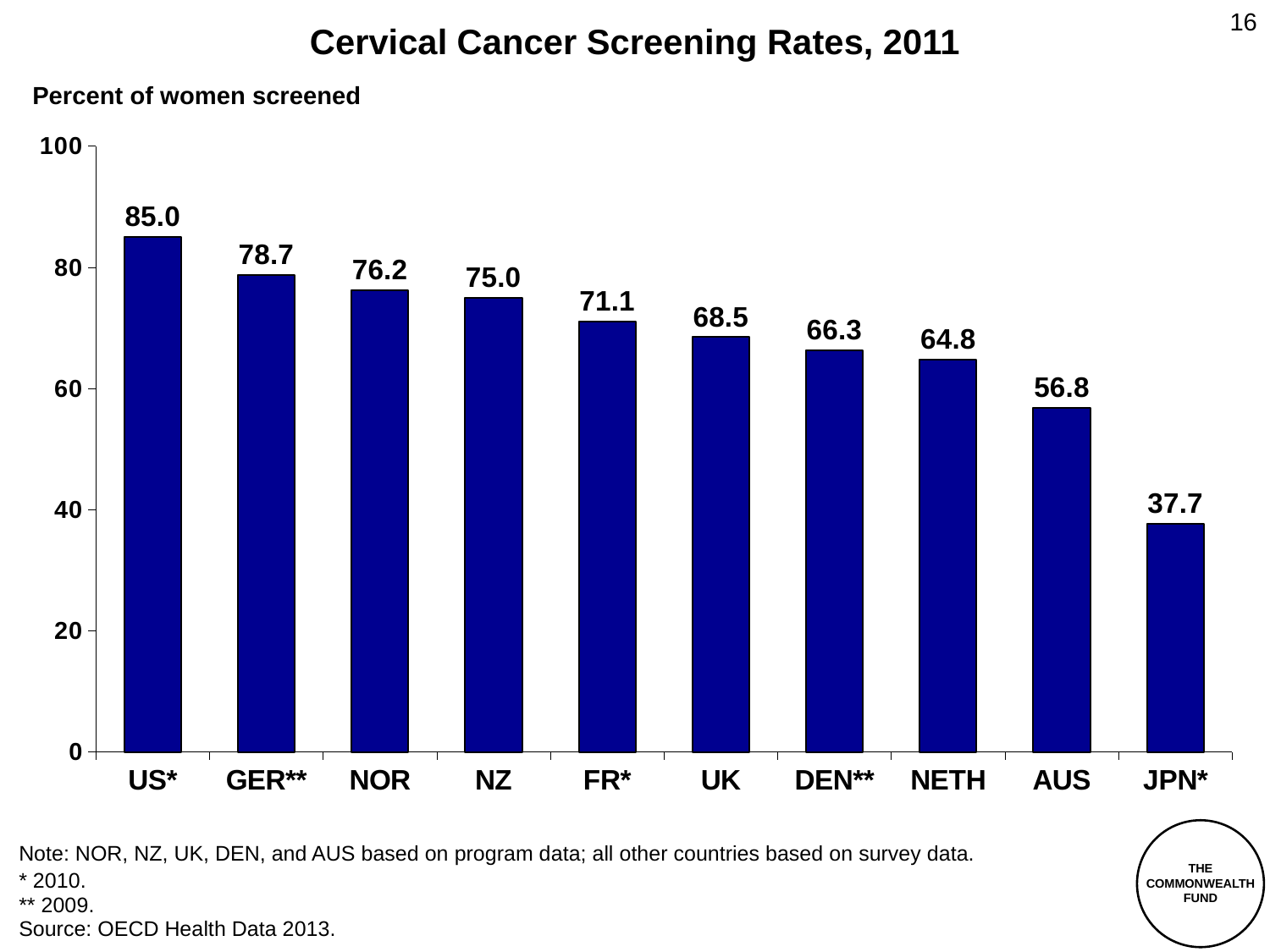
What is the difference between the values for GER** and NETH? 13.9 What is the value shown for DEN**? 66.3 Which country has the lowest screening rate? JPN* How many countries are shown in the chart? 10 Is the value for FR* greater or less than 80? less What kind of chart is shown on the slide? Bar chart What is the difference between the values for US* and JPN*? 47.3 Which has a higher screening rate, UK or NZ? NZ Which country has the highest screening rate? US* What is the cervical cancer screening rate for NOR? 76.2 What is the value shown for AUS? 56.8 Do the values rise or fall moving from left to right along the x axis? Fall